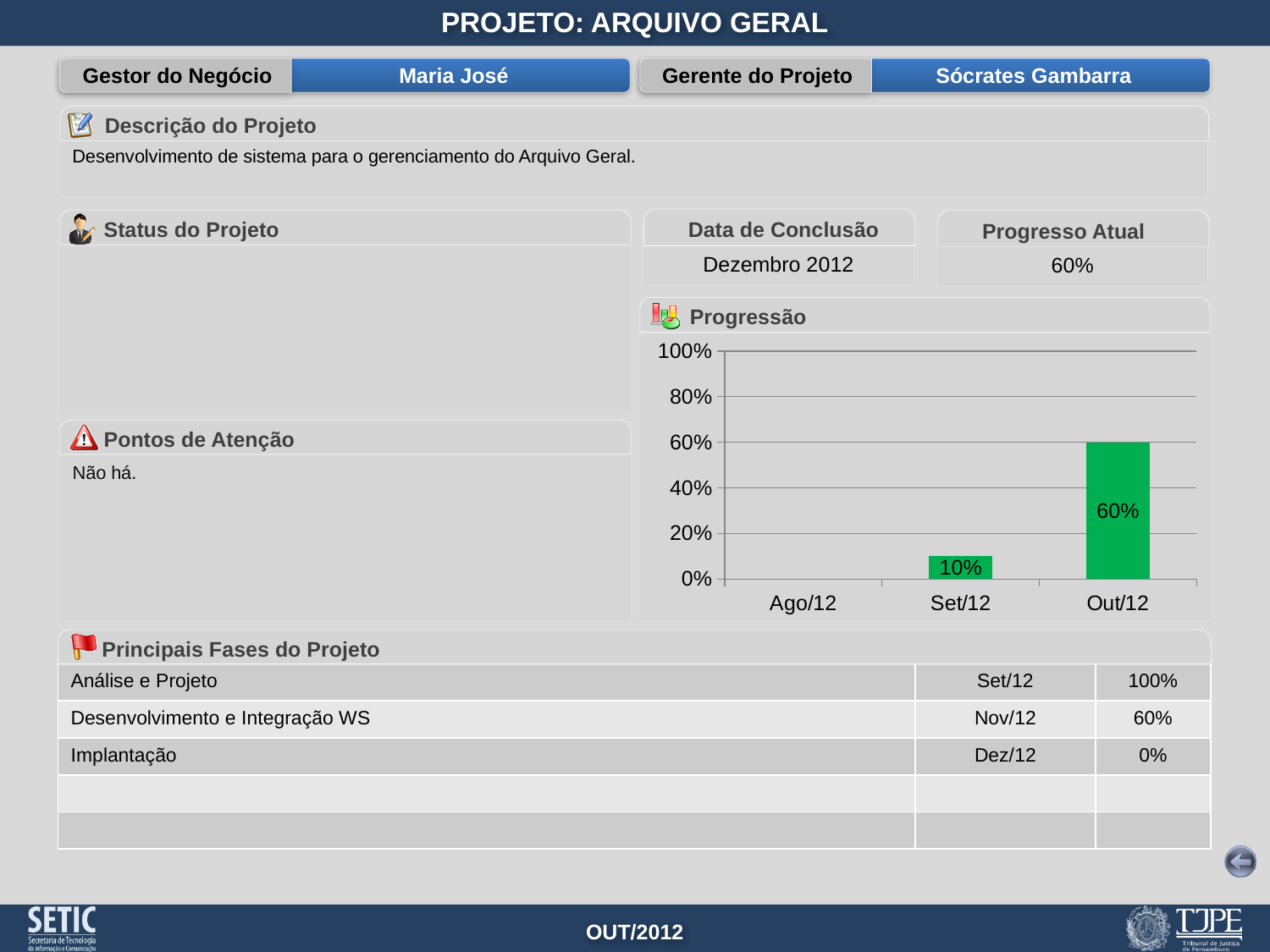
Do the values in the Progressão chart rise or fall from Set/12 to Out/12? rise In the Progressão chart, which is larger: the value for Set/12 or the value for Out/12? Out/12 Which month has the highest value in the Progressão chart? Out/12 What is the difference between the Out/12 and Set/12 values in the Progressão chart? 50% What is the value for Out/12 in the Progressão chart? 60% What colour are the bars in the Progressão chart? green Is the value for Out/12 in the Progressão chart greater or less than 40%? greater Is the value for Set/12 in the Progressão chart greater or less than 20%? less What kind of chart is the Progressão chart? bar chart What is the value for Set/12 in the Progressão chart? 10% How many months are shown on the x axis of the Progressão chart? 3 What is the title of the chart on the slide? Progressão